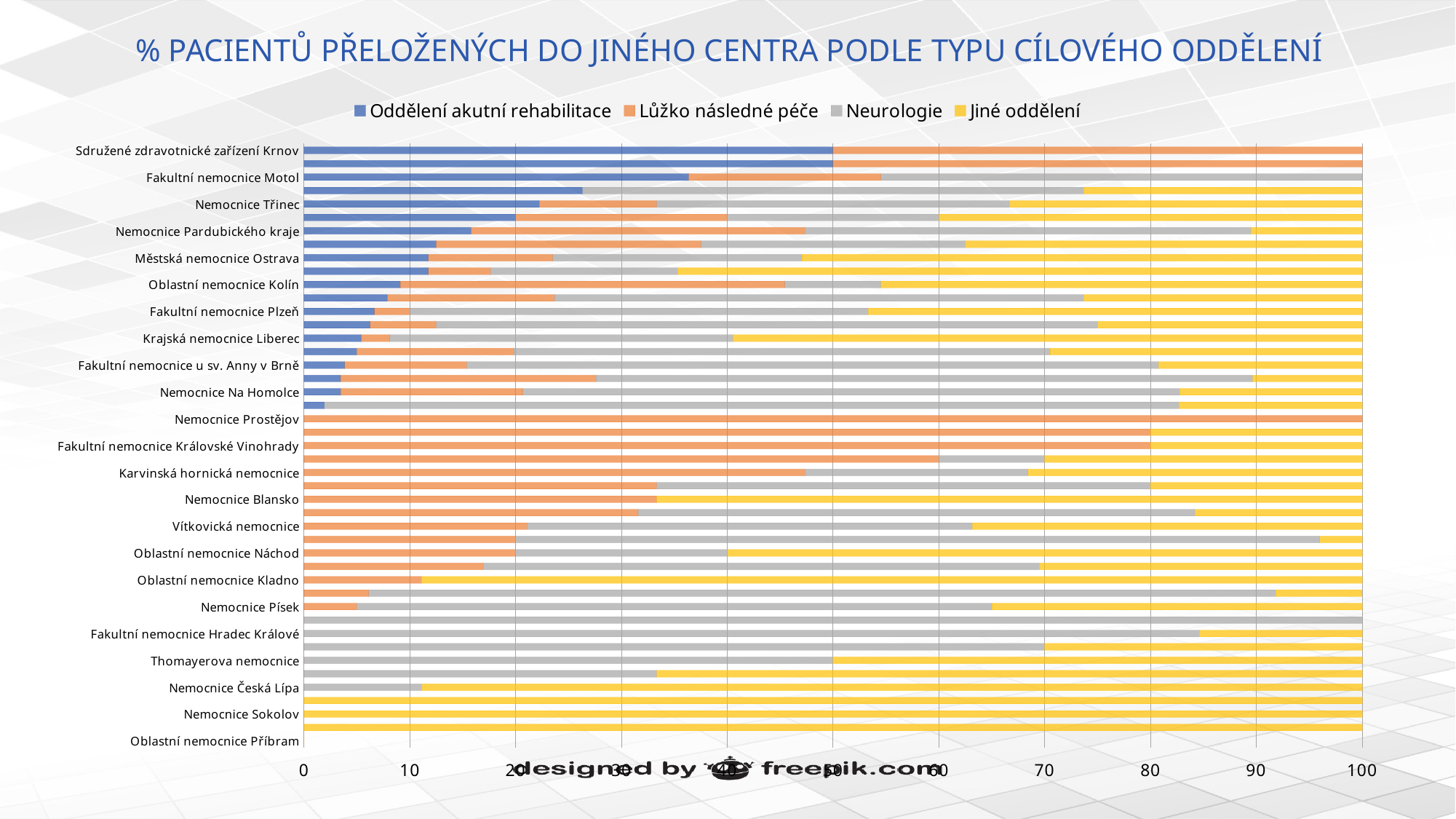
Which has the larger value of Oddělení akutní rehabilitace, Sdružené zdravotnické zařízení Krnov or Fakultní nemocnice Motol? Sdružené zdravotnické zařízení Krnov What is the value of Lůžko následné péče for Nemocnice Prostějov? 100 Which series is shown in yellow in the legend? Jiné oddělení Is the value of Lůžko následné péče for Fakultní nemocnice Královské Vinohrady greater or less than 70? greater What is the value of Jiné oddělení for Oblastní nemocnice Příbram? 0 Is the value of Oddělení akutní rehabilitace for Fakultní nemocnice Motol greater or less than 30? greater How many series does the legend list? 4 What is the title of the chart? % PACIENTŮ PŘELOŽENÝCH DO JINÉHO CENTRA PODLE TYPU CÍLOVÉHO ODDĚLENÍ Is the value of Oddělení akutní rehabilitace for Nemocnice Pardubického kraje greater or less than 20? less What kind of chart is shown on the slide? bar chart